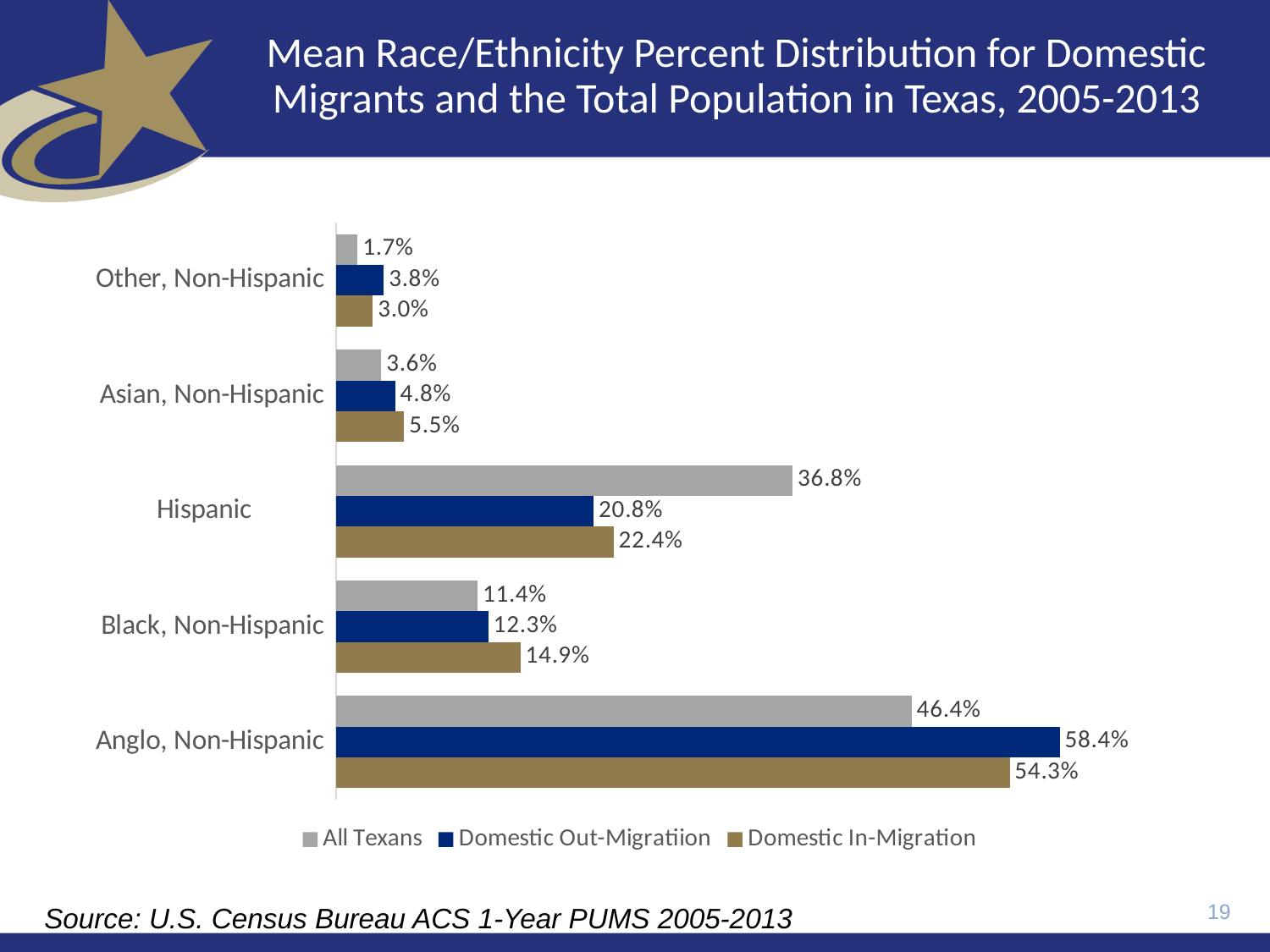
What is the Domestic In-Migration value for Anglo, Non-Hispanic? 54.3% Which is larger for Asian, Non-Hispanic: the Domestic In-Migration value or the All Texans value? Domestic In-Migration Which series is shown in gray in the legend? All Texans How many series does the legend list? 3 What kind of chart is shown on the slide? Bar chart Which category has the lowest All Texans value? Other, Non-Hispanic Which category has the highest Domestic Out-Migratiion value? Anglo, Non-Hispanic What is the All Texans value for Other, Non-Hispanic? 1.7% How many race/ethnicity categories are shown on the chart? 5 What is the All Texans value for Hispanic? 36.8% What is the Domestic Out-Migratiion value for Black, Non-Hispanic? 12.3% What is the difference between the All Texans and Domestic Out-Migratiion values for Hispanic? 16.0%